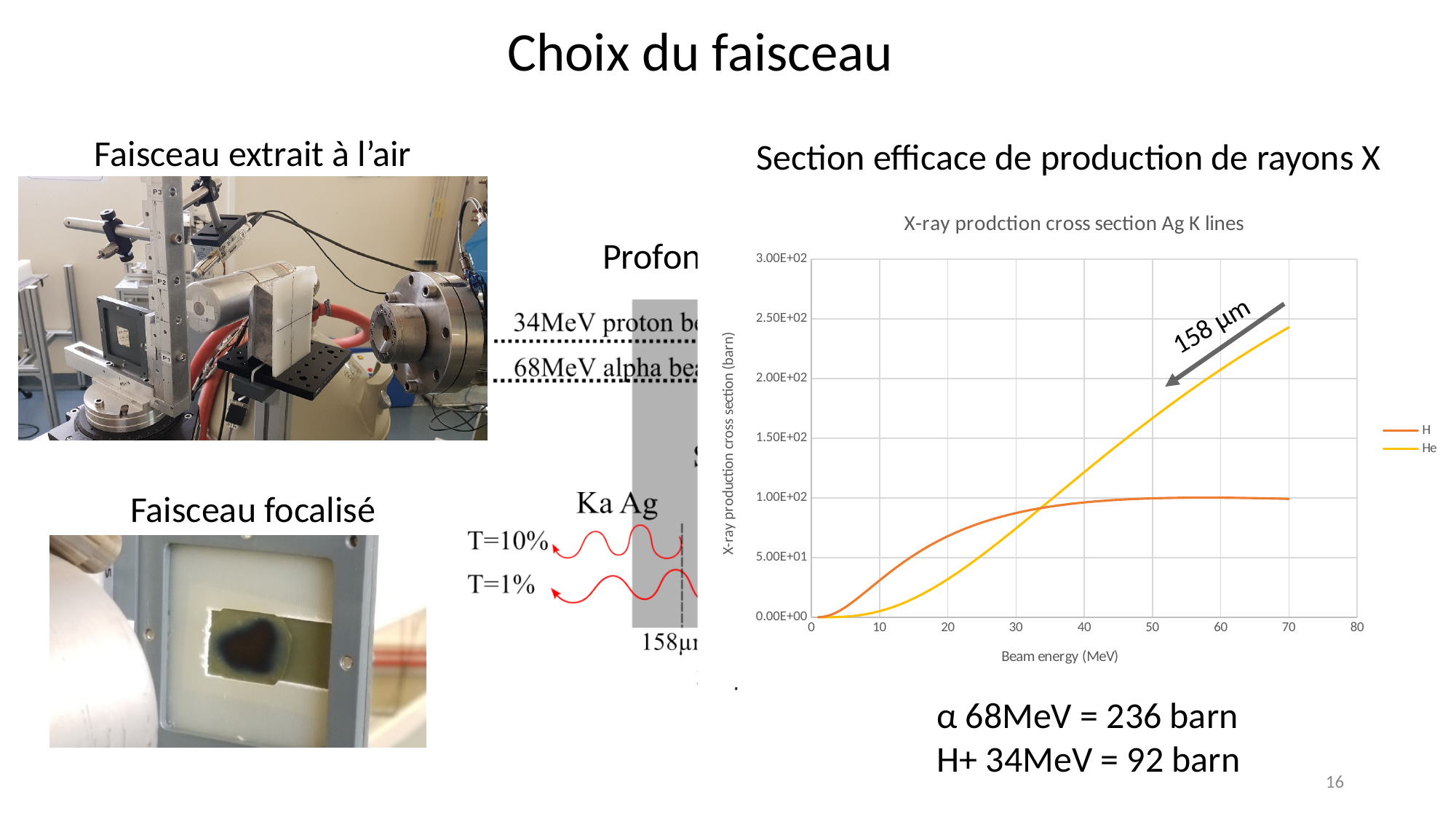
In the 'X-ray prodction cross section Ag K lines' chart, is the He value at 20 MeV greater or less than 5.00E+01? less In the 'X-ray prodction cross section Ag K lines' chart, which series has the higher value at 60 MeV, H or He? He According to the text below the 'X-ray prodction cross section Ag K lines' chart, what is the cross section for α at 68MeV? 236 barn In the 'X-ray prodction cross section Ag K lines' chart, which series has the higher value at 20 MeV, H or He? H In the 'X-ray prodction cross section Ag K lines' chart, does the He series rise or fall as beam energy increases? rise In the 'X-ray prodction cross section Ag K lines' chart, is the H value at 70 MeV greater or less than 1.50E+02? less What type of chart is shown under 'Section efficace de production de rayons X'? line chart In the 'X-ray prodction cross section Ag K lines' chart, is the H value at 20 MeV greater or less than 5.00E+01? greater What are the two series named in the legend of the 'X-ray prodction cross section Ag K lines' chart? H and He How many series does the legend of the 'X-ray prodction cross section Ag K lines' chart list? 2 What is the x-axis label of the 'X-ray prodction cross section Ag K lines' chart? Beam energy (MeV)